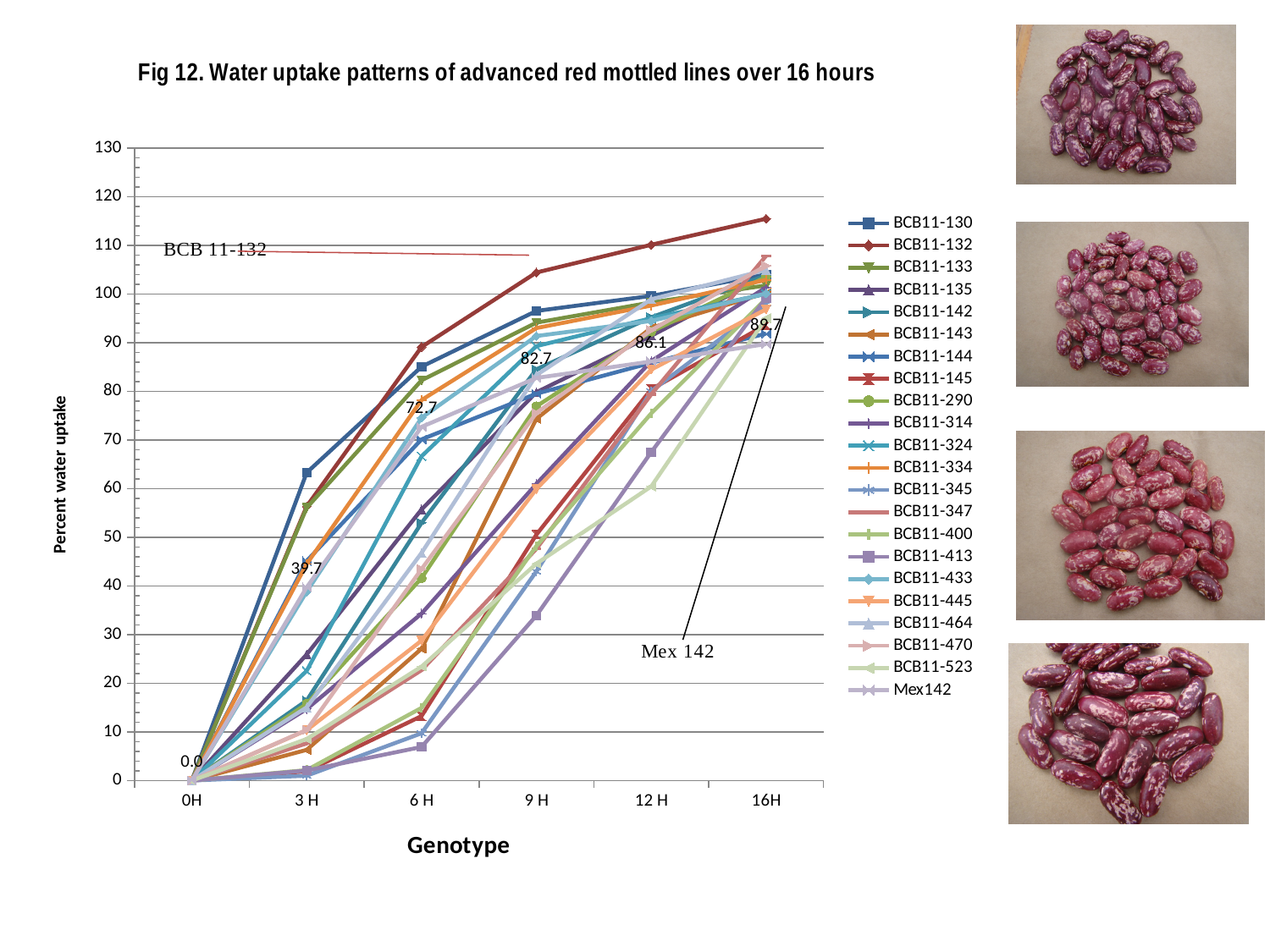
Is the value for BCB11-413 at 6 H greater or less than 10? less How many time points are shown on the x axis? 6 What is the title of the chart? Fig 12. Water uptake patterns of advanced red mottled lines over 16 hours What is the labelled value for Mex142 at 16H? 89.7 Which series has the highest value at 16H? BCB11-132 Is the value for BCB11-132 at 16H greater or less than 110? greater How many series does the legend list? 22 What is the difference between the Mex142 values at 16H and 3 H? 50.0 What is the labelled value for Mex142 at 3 H? 39.7 Does the Mex142 series rise or fall from 0H to 16H? Rises What type of chart is shown on the slide? Line chart What is the labelled value for Mex142 at 9 H? 82.7